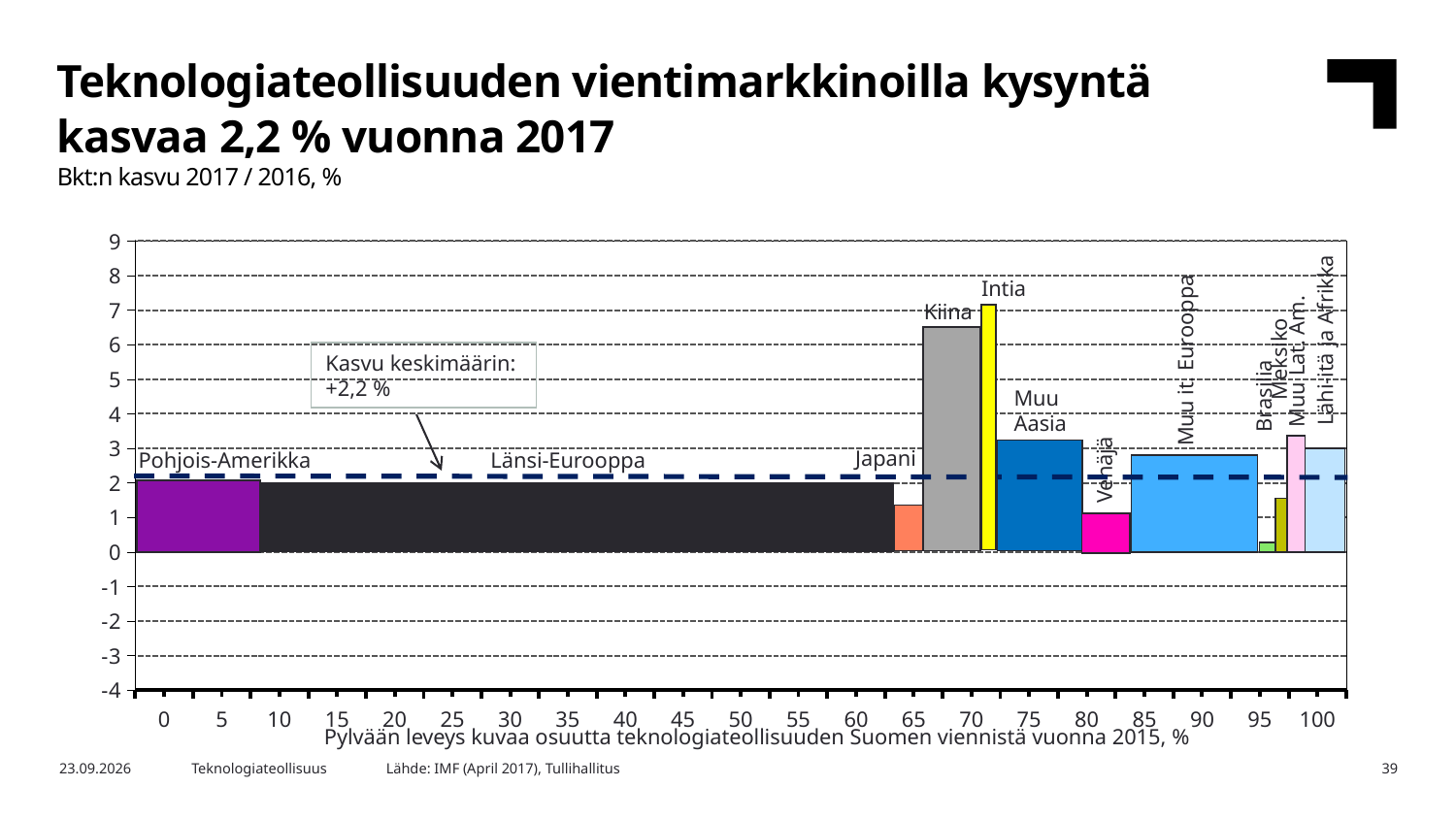
Is the value for Kiina greater or less than 6? greater Is the value for Brasilia greater or less than 1? less What average growth (Kasvu keskimäärin) is marked by the dashed line in the chart? +2,2 % According to the note under the x axis, what does the width of each bar represent? Share of Finland's technology industry exports in 2015, % Is the value for Venäjä greater or less than 2? less How many regions are shown as bars in the chart? 12 Which has higher GDP growth, Kiina or Japani? Kiina What kind of chart is shown on the slide? bar chart Which has higher GDP growth, Muu Aasia or Venäjä? Muu Aasia Which region has the lowest GDP growth in the chart? Brasilia Which region has the highest GDP growth in the chart? Intia Which has higher GDP growth, Intia or Kiina? Intia